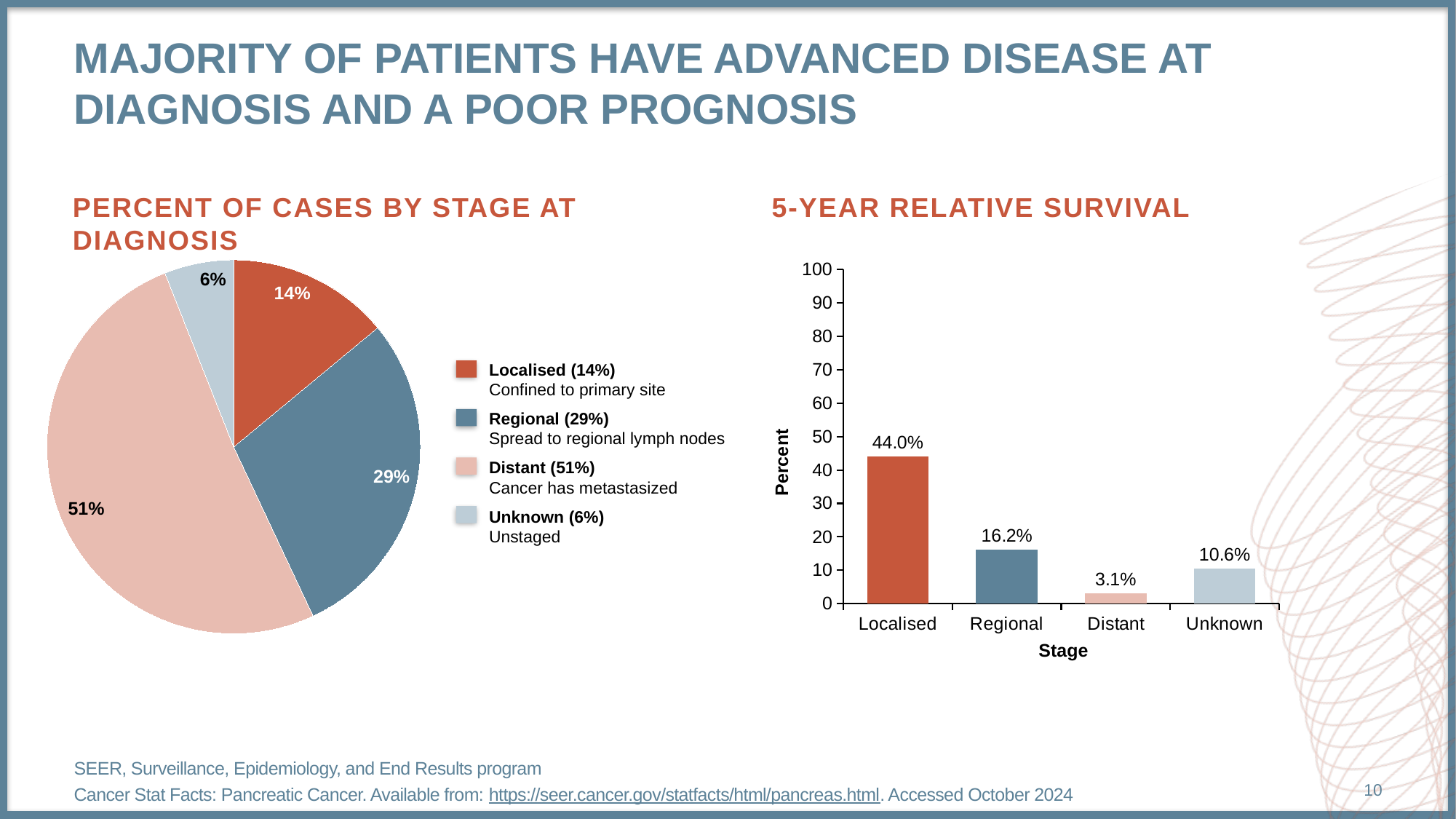
In the '5-year relative survival' chart, which stage has the highest survival? Localised In the '5-year relative survival' chart, what is the difference between the Regional and Unknown values? 5.6% In the 'Percent of cases by stage at diagnosis' pie chart, what share of cases is Regional? 29% In the '5-year relative survival' chart, what is the label of the y axis? Percent In the 'Percent of cases by stage at diagnosis' pie chart, which stage has the smallest slice? Unknown In the '5-year relative survival' chart, what is the value for Localised? 44.0% In the '5-year relative survival' chart, which stage has the lowest survival? Distant In the '5-year relative survival' chart, what is the value for Distant? 3.1% In the 'Percent of cases by stage at diagnosis' pie chart, how many slices are there? 4 In the 'Percent of cases by stage at diagnosis' pie chart, what share of cases is Distant? 51% What kind of chart is the '5-year relative survival' chart? Bar chart In the 'Percent of cases by stage at diagnosis' pie chart, what is the difference in percentage points between the Distant and Localised slices? 37